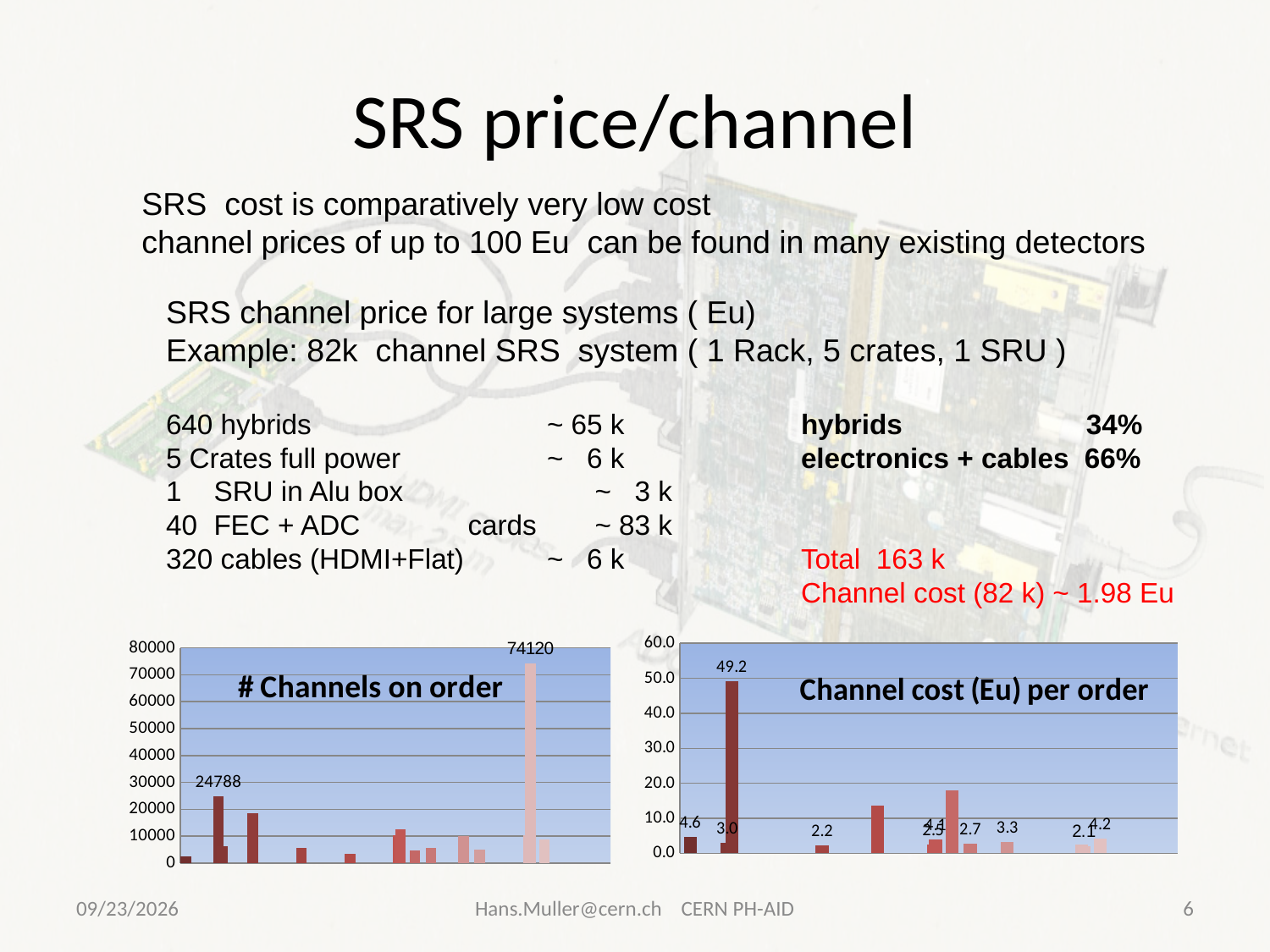
In the 'Channel cost (Eu) per order' chart, what is the value of the tallest bar? 49.2 In the '# Channels on order' chart, what is the value of the tallest bar? 74120 In the '# Channels on order' chart, what is the difference between the two labelled bars, 74120 and 24788? 49332 In the 'Channel cost (Eu) per order' chart, is the tallest bar greater or less than 40.0? greater What kind of chart is the '# Channels on order' chart? bar chart What kind of chart is the 'Channel cost (Eu) per order' chart? bar chart In the '# Channels on order' chart, what is the value of the second-tallest bar, labelled near the left of the chart? 24788 In the 'Channel cost (Eu) per order' chart, is the first bar on the left greater or less than 10.0? less In the '# Channels on order' chart, which labelled bar is larger, the one labelled 74120 or the one labelled 24788? 74120 In the '# Channels on order' chart, is the tallest bar greater or less than 70000? greater What is the highest value shown on the y axis of the '# Channels on order' chart? 80000 What is the highest value shown on the y axis of the 'Channel cost (Eu) per order' chart? 60.0